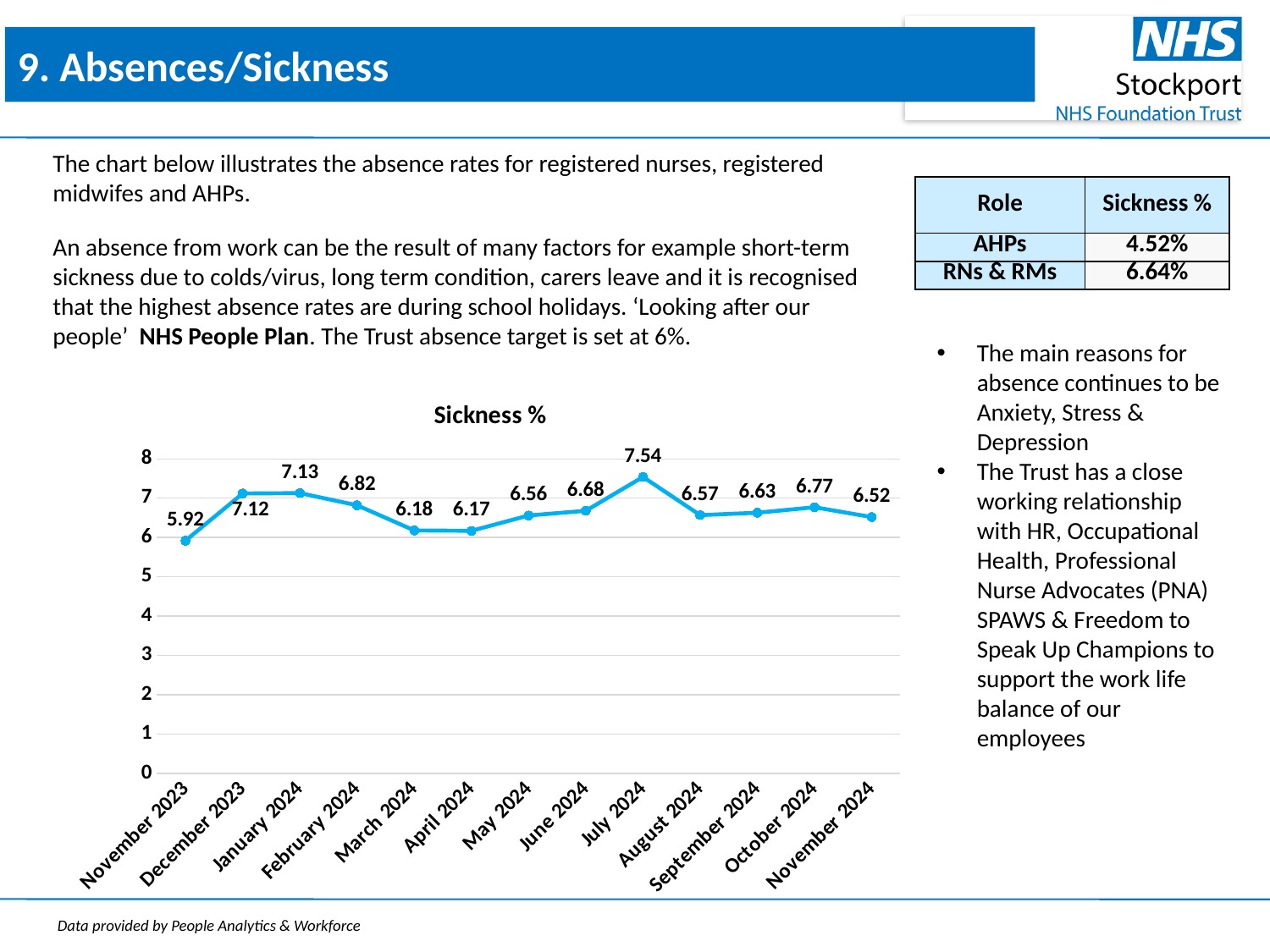
What is the Sickness % value for March 2024? 6.18 Which is larger, the Sickness % value for February 2024 or for October 2024? February 2024 How many months are plotted on the chart? 13 What type of chart is shown on the slide? line chart What is the difference between the Sickness % values for July 2024 and November 2023? 1.62 Does the Sickness % value rise or fall from March 2024 to July 2024? rise Is the Sickness % value for December 2023 greater or less than 7? greater What is the Sickness % value for July 2024? 7.54 What is the Sickness % value for November 2023? 5.92 Which month has the highest Sickness % value? July 2024 Which month has the lowest Sickness % value? November 2023 What is the title of the chart? Sickness %